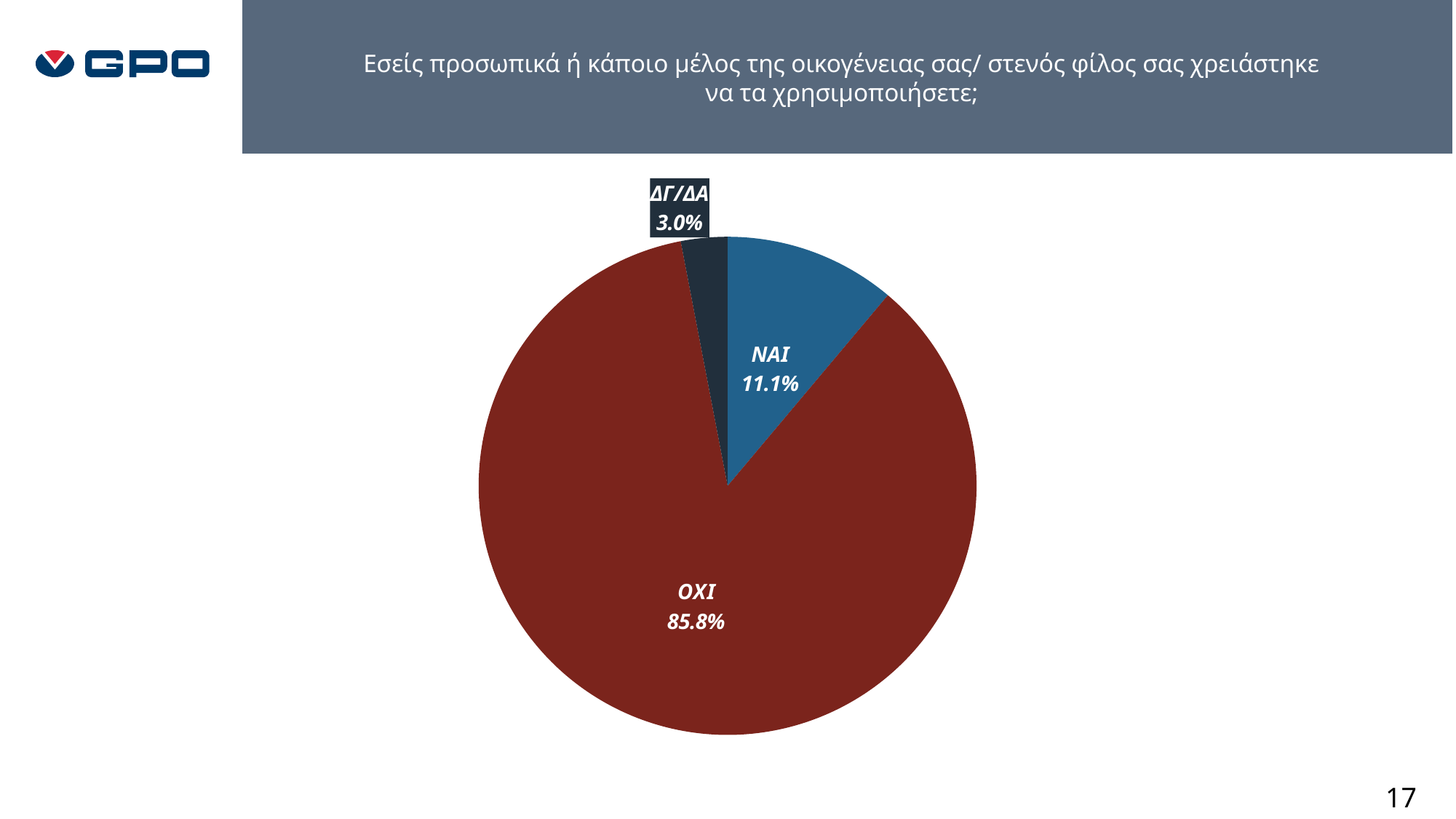
What is the value shown for ΔΓ/ΔΑ? 3.0% What share of the pie does ΟΧΙ take? 85.8% What is the value shown for ΝΑΙ? 11.1% What colour is the ΝΑΙ slice? blue Which slice of the pie is the largest? ΟΧΙ What colour is the ΟΧΙ slice? dark red Which slice of the pie is the smallest? ΔΓ/ΔΑ Which is larger, the value for ΝΑΙ or the value for ΔΓ/ΔΑ? ΝΑΙ How many slices does the pie chart have? 3 What is the difference in percentage points between ΝΑΙ and ΔΓ/ΔΑ? 8.1 What is the difference in percentage points between ΟΧΙ and ΝΑΙ? 74.7 What kind of chart is shown on the slide? pie chart